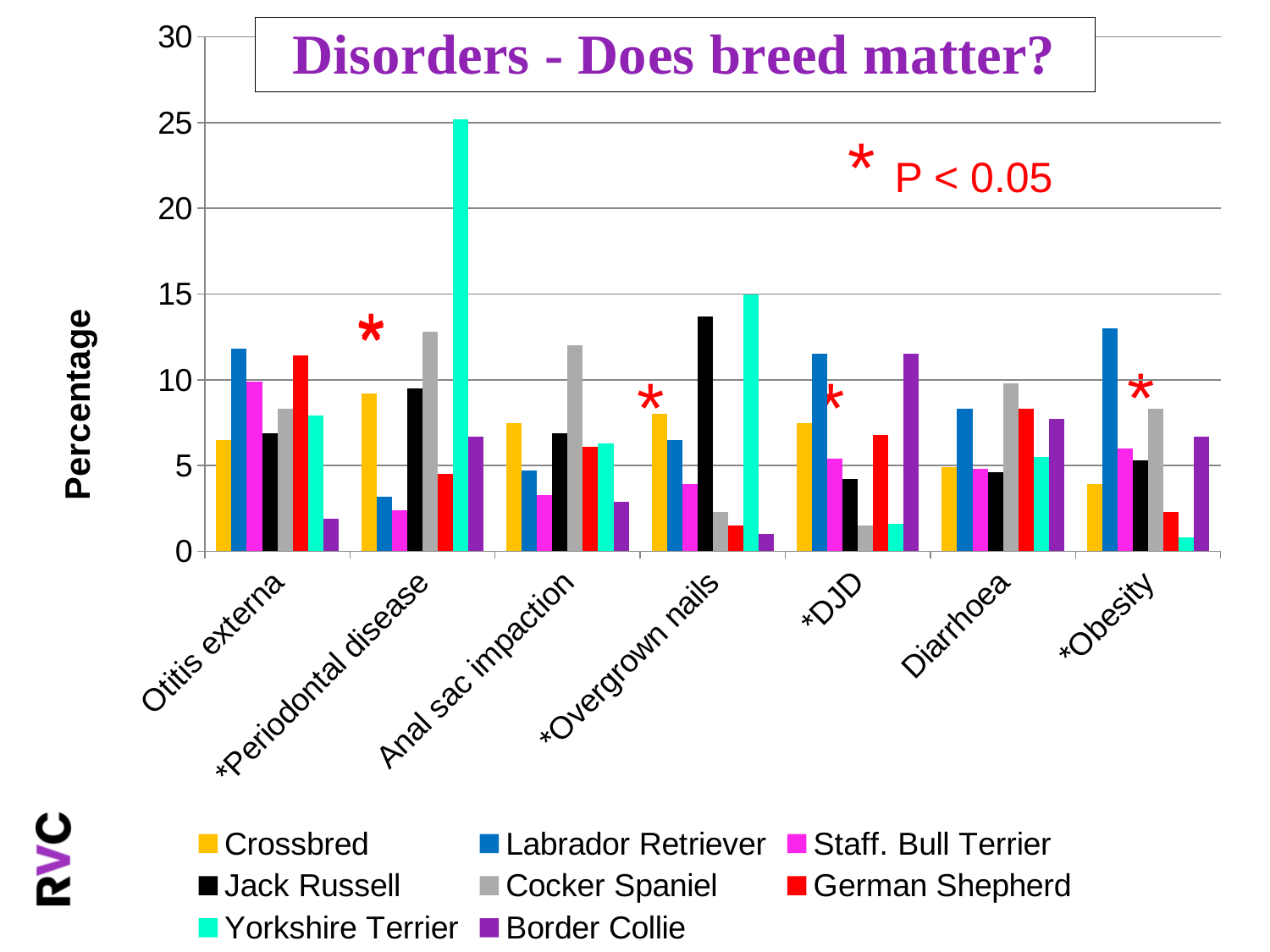
Which breed has the lowest percentage for Otitis externa? Border Collie Which breed has the highest percentage for *Overgrown nails? Yorkshire Terrier How many disorder categories are shown on the x axis? 7 Which breed has the highest percentage for *Obesity? Labrador Retriever For Anal sac impaction, which is larger: the Crossbred value or the Labrador Retriever value? Crossbred Is the Cocker Spaniel value for Anal sac impaction greater or less than 10? greater Is the Yorkshire Terrier value for *Periodontal disease greater or less than 20? greater What kind of chart is shown on the slide? bar chart Is the Labrador Retriever value for *Obesity greater or less than 10? greater Which breed has the highest percentage for *Periodontal disease? Yorkshire Terrier What is the label on the y axis? Percentage How many breeds does the legend list? 8